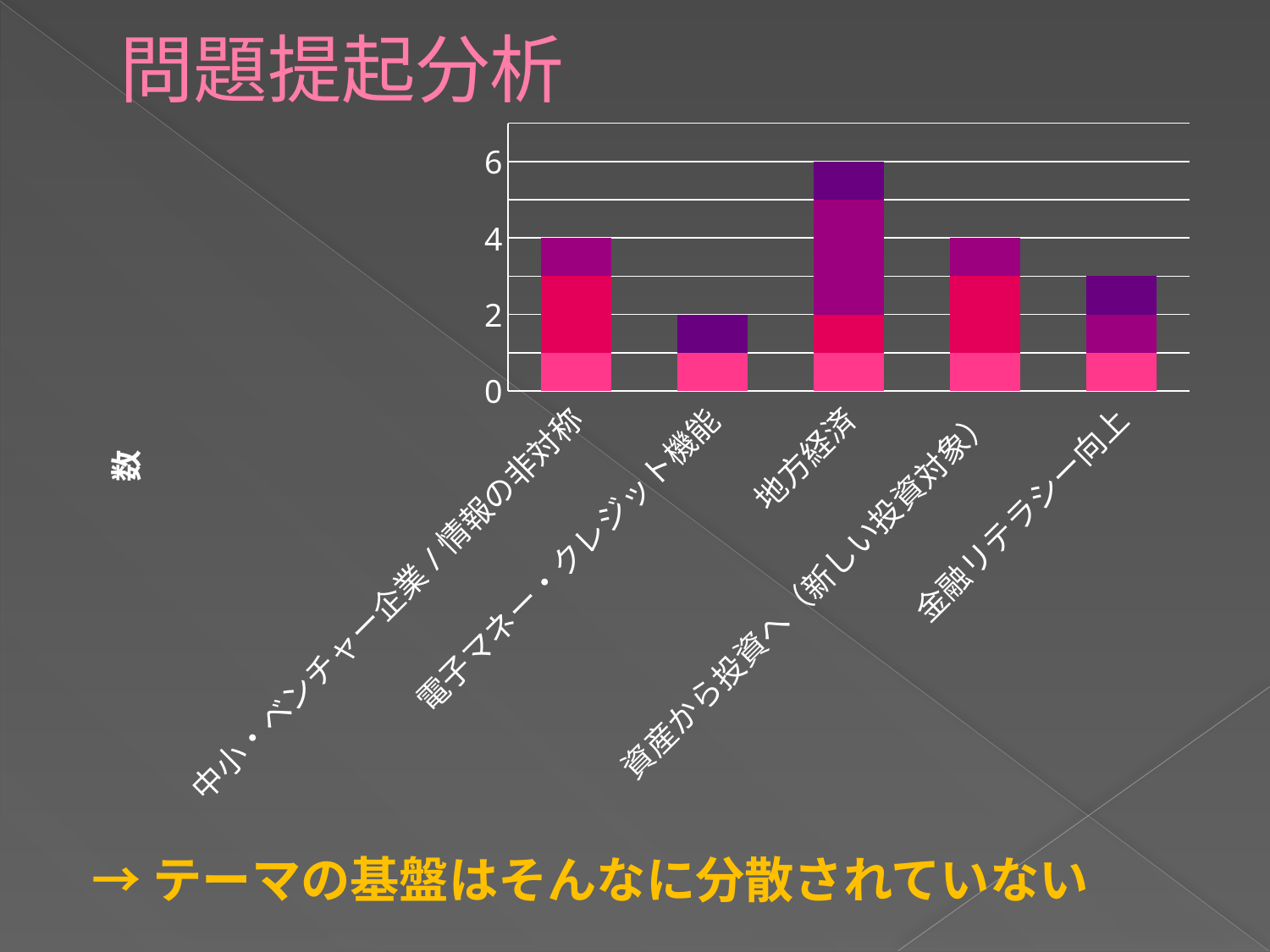
Which category has the shortest bar in the chart? 電子マネー・クレジット機能 What is the total height of the stacked bar for 資産から投資へ（新しい投資対象）? 4 What is the total height of the stacked bar for 電子マネー・クレジット機能? 2 What kind of chart is shown on the slide? Stacked bar chart What is the difference between the total for 地方経済 and the total for 電子マネー・クレジット機能? 4 How many categories are shown on the x axis of the chart? 5 Which bar is taller, 地方経済 or 金融リテラシー向上? 地方経済 What is the total height of the stacked bar for 地方経済? 6 What is the label on the vertical axis of the chart? 数 Is the total value for 金融リテラシー向上 greater or less than 4? less Which category has the tallest bar in the chart? 地方経済